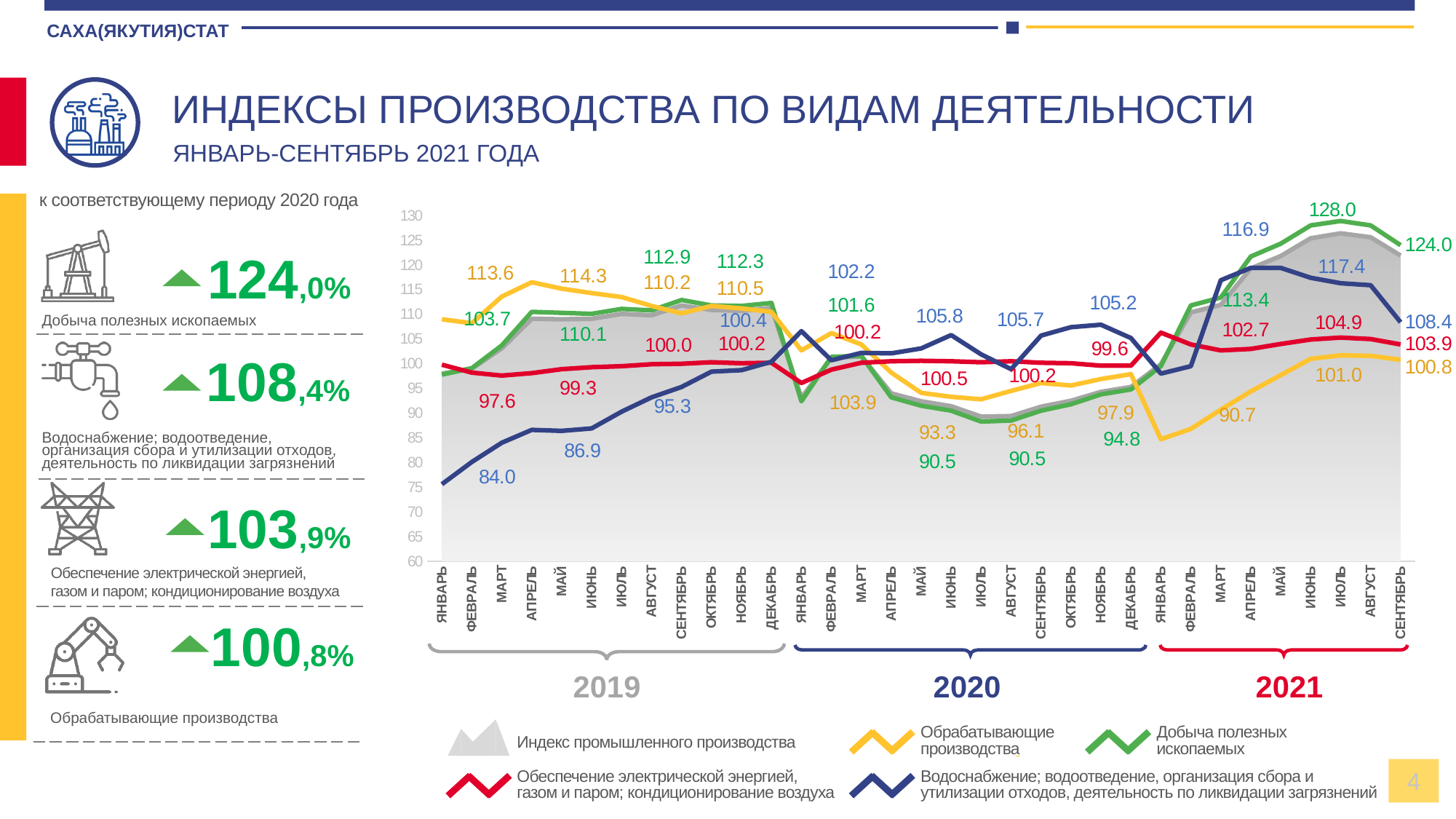
Is the value for Обрабатывающие производства in January 2021 (ЯНВАРЬ 2021) greater or less than 90? less Which years are marked under the x axis of the chart? 2019, 2020, 2021 What is the value for Обеспечение электрической энергией, газом и паром in September 2021? 103.9 How many series does the chart legend list? 5 What is the difference between the September 2021 values for Добыча полезных ископаемых (124.0) and Обрабатывающие производства (100.8)? 23.2 What kind of chart is shown on the slide? area and line chart In September 2021, which is larger: Добыча полезных ископаемых or Обрабатывающие производства? Добыча полезных ископаемых What is the value for Добыча полезных ископаемых in September 2021 (СЕНТЯБРЬ 2021)? 124.0 What is the highest labelled value on the Добыча полезных ископаемых line? 128.0 What is the value for Водоснабжение; водоотведение, организация сбора и утилизации отходов in September 2021? 108.4 What is the lowest labelled value on the Водоснабжение; водоотведение line? 84.0 How many months are shown on the x axis of the chart? 33